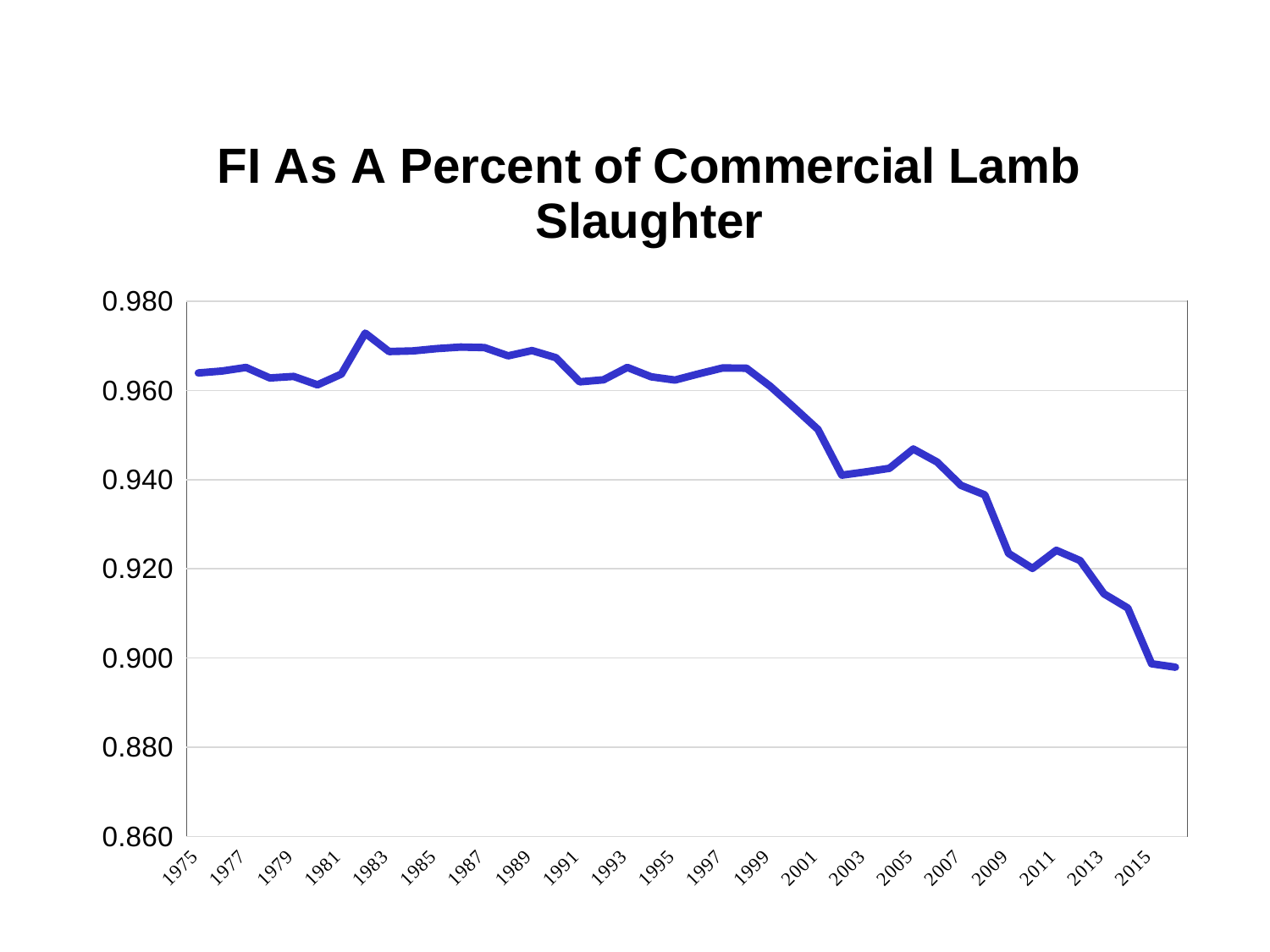
Which year has the larger value, 1983 or 2015? 1983 Overall, do the values rise or fall from 1975 to the end of the series? fall What kind of chart is shown on the slide? line chart Is the value for 1975 greater or less than 0.960? greater Is the value for 1997 greater or less than 0.960? greater In which year does the line reach its highest value? 1982 Is the value for 2015 greater or less than 0.920? less What is the lowest value shown on the vertical axis? 0.860 Which year has the larger value, 2001 or 2013? 2001 What is the title of the chart? FI As A Percent of Commercial Lamb Slaughter